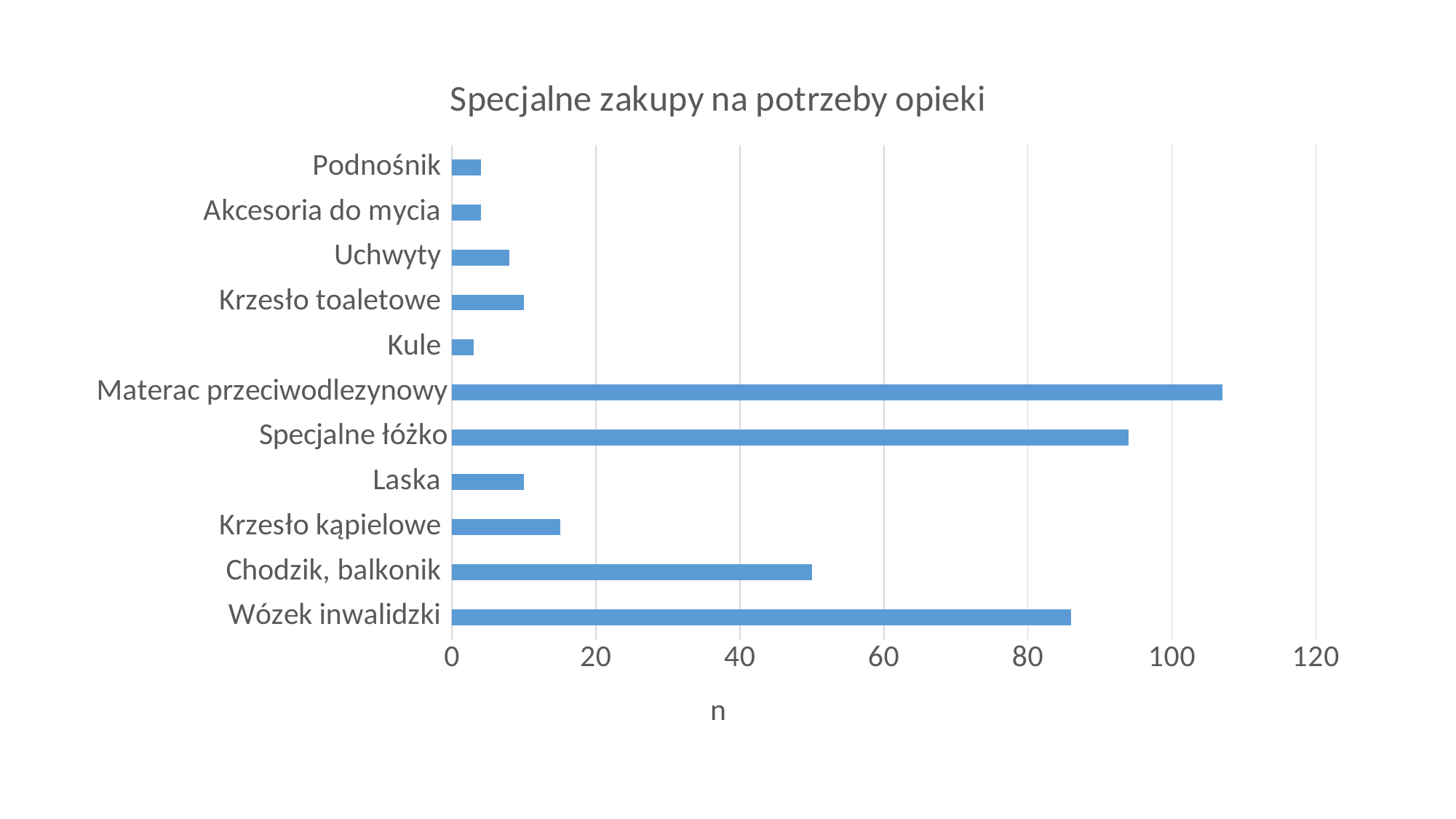
What type of chart is shown on the slide? bar chart Is the value for Wózek inwalidzki greater or less than 80? greater How many categories are shown in the chart? 11 What is the title of the chart? Specjalne zakupy na potrzeby opieki Is the value for Materac przeciwodleżynowy greater or less than 100? greater Which has a larger value, Specjalne łóżko or Wózek inwalidzki? Specjalne łóżko What is the label of the horizontal axis? n Is the value for Specjalne łóżko greater or less than 100? less Which category has the highest value? Materac przeciwodlezynowy Which has a larger value, Krzesło kąpielowe or Laska? Krzesło kąpielowe